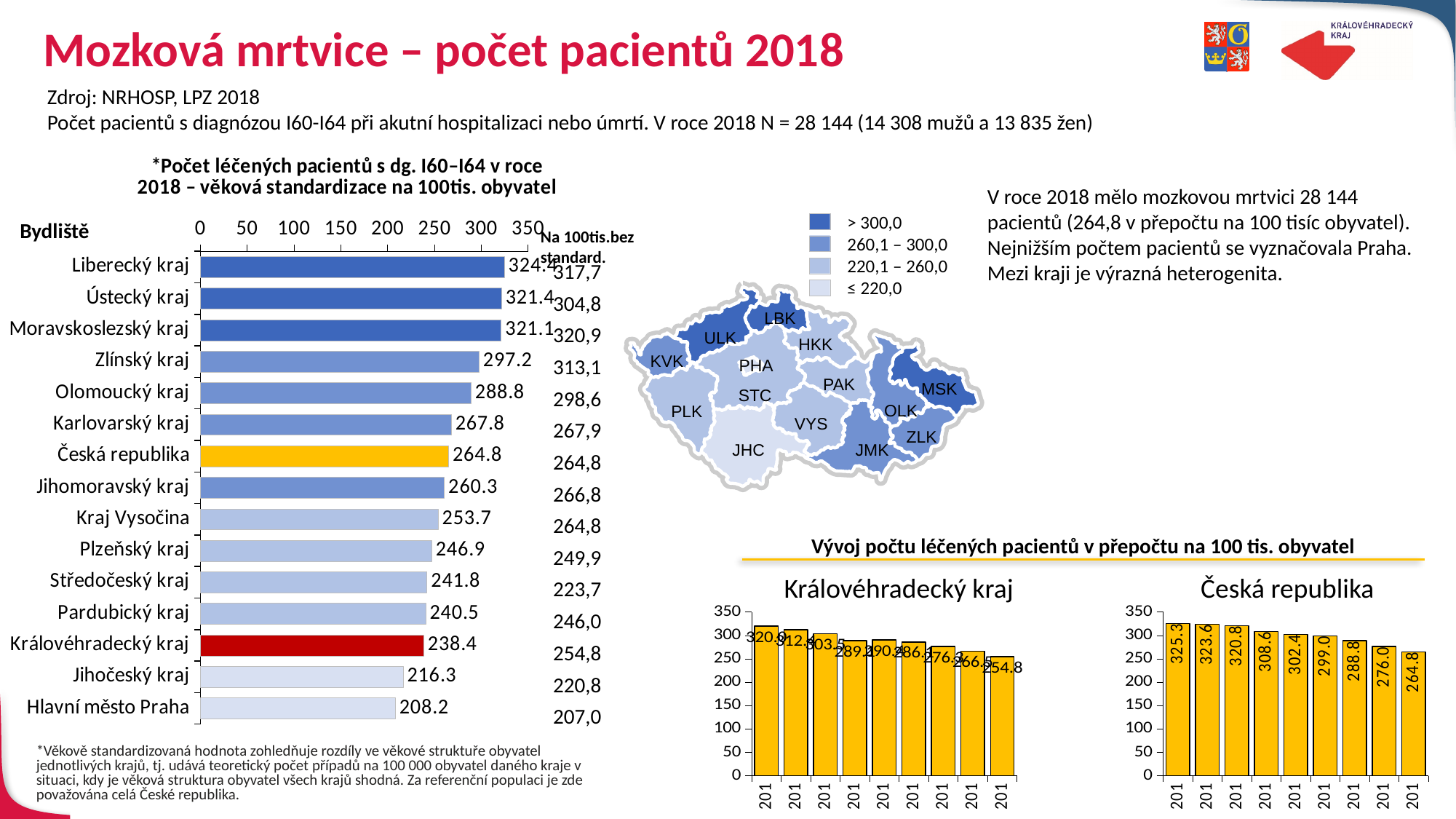
In the bottom-right chart titled Česká republika, what is the value of the last (rightmost) bar? 264.8 In the left bar chart of age-standardized patients per 100 thousand inhabitants in 2018, which is larger: Zlínský kraj or Olomoucký kraj? Zlínský kraj In the left bar chart of age-standardized patients per 100 thousand inhabitants in 2018, what is the value for Liberecký kraj? 324.4 In the bottom-right chart titled Česká republika, do the values rise or fall over time from left to right? Fall What type of chart is the left chart of age-standardized patients per 100 thousand inhabitants in 2018? Bar chart In the left bar chart of age-standardized patients per 100 thousand inhabitants in 2018, which region has the highest value? Liberecký kraj How many bars (regions including Česká republika) are shown in the left bar chart of age-standardized patients per 100 thousand inhabitants in 2018? 15 In the left bar chart of age-standardized patients per 100 thousand inhabitants in 2018, what is the difference between Česká republika and Královéhradecký kraj? 26.4 In the left bar chart of age-standardized patients per 100 thousand inhabitants in 2018, what is the value for Královéhradecký kraj? 238.4 In the left bar chart of age-standardized patients per 100 thousand inhabitants in 2018, which bar is coloured yellow? Česká republika How many bars are shown in the bottom chart titled Královéhradecký kraj? 9 In the left bar chart of age-standardized patients per 100 thousand inhabitants in 2018, which region has the lowest value? Hlavní město Praha